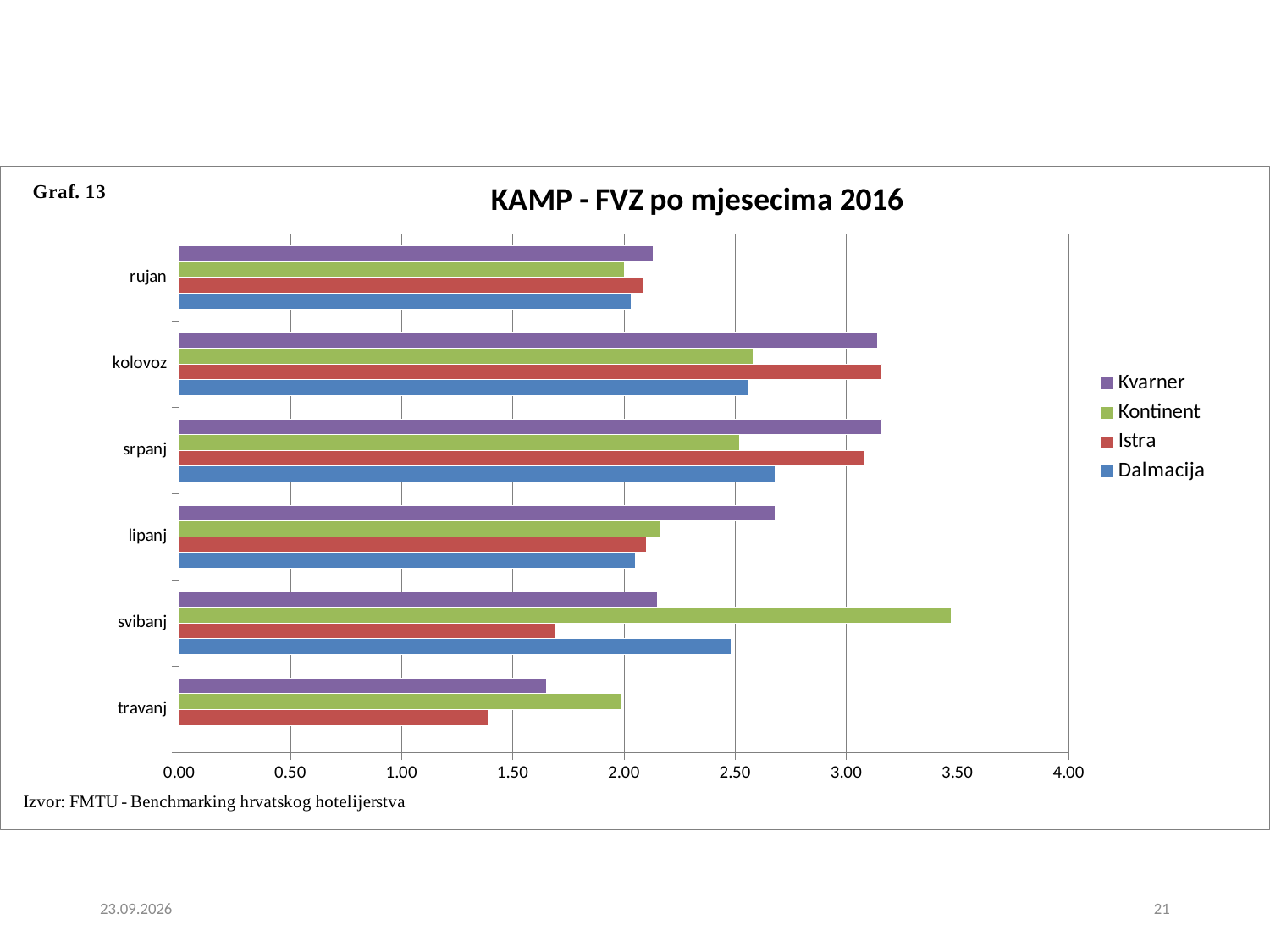
Which series has the highest value in svibanj? Kontinent In srpanj, which is larger: the value for Kvarner or the value for Kontinent? Kvarner Which series is shown in green in the legend? Kontinent What is the title of the chart? KAMP - FVZ po mjesecima 2016 How many months (categories) are shown on the vertical axis? 6 Which series has the lowest value in travanj? Istra Is the value for Kontinent in svibanj greater or less than 3.00? greater Is the value for Istra in svibanj greater or less than 2.00? less Is the value for Kvarner in kolovoz greater or less than 3.00? greater How many series does the legend list? 4 What type of chart is shown on the slide? bar chart